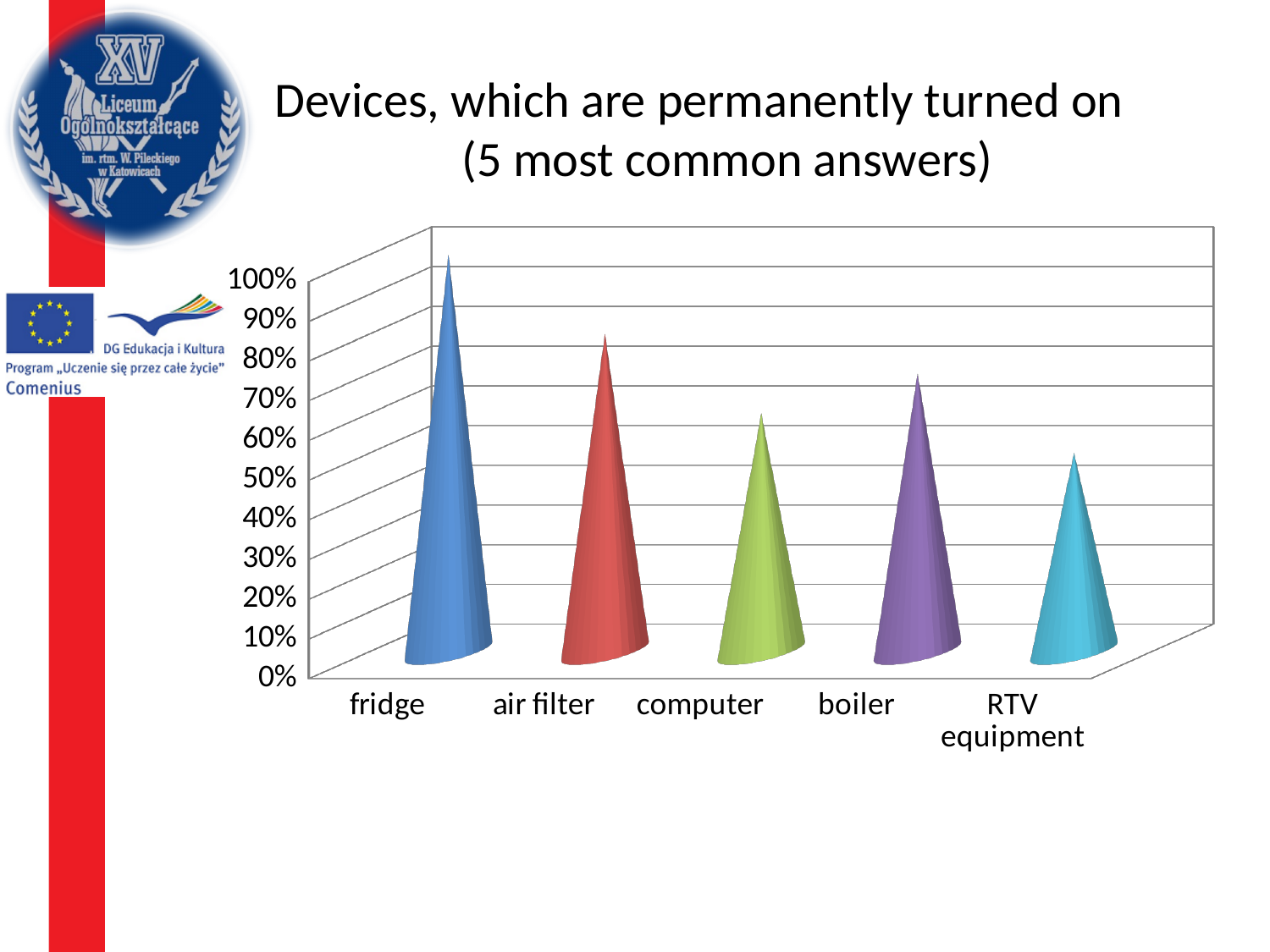
Is the value for boiler greater or less than 50%? greater Is the value for air filter greater or less than 60%? greater Is the value for computer greater or less than 80%? less What is the title of the chart? Devices, which are permanently turned on (5 most common answers) How many devices are shown on the x axis of the chart? 5 Which has a larger value, air filter or RTV equipment? air filter What kind of chart is shown on the slide? bar chart Which device has the highest value in the chart? fridge Which has a larger value, boiler or computer? boiler Which device has the lowest value in the chart? RTV equipment